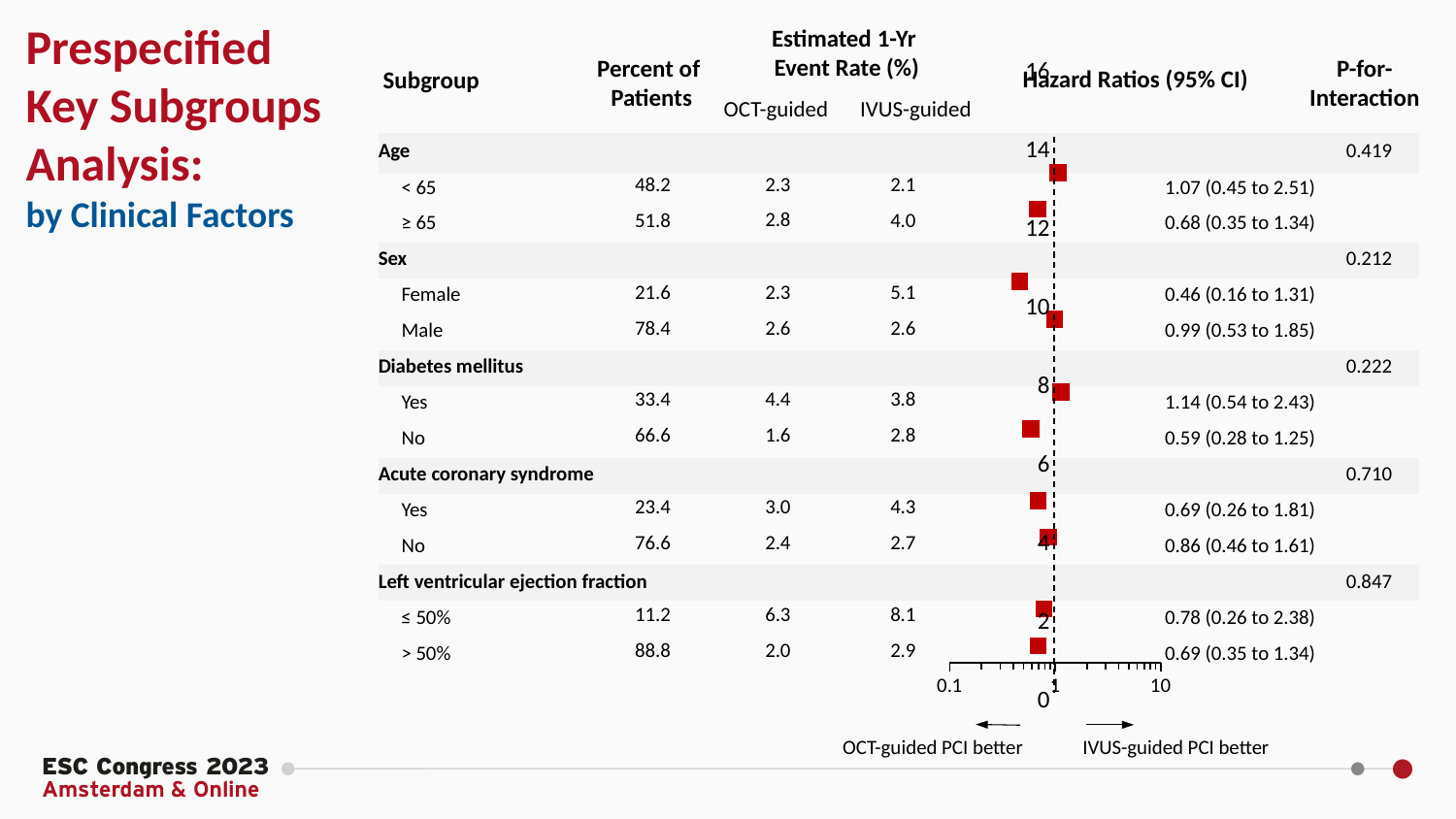
How many subgroup hazard ratio points are plotted in the forest plot? 10 Is the hazard ratio for the Female subgroup greater or less than 1? less What is the hazard ratio (95% CI) for patients with diabetes mellitus (Yes)? 1.14 (0.54 to 2.43) Is the hazard ratio for the Age < 65 subgroup greater or less than 1? greater What kind of chart is used to display the hazard ratios? Forest plot What does the label under the left-pointing arrow below the forest plot say? OCT-guided PCI better Which subgroup has the lowest point estimate hazard ratio in the forest plot? Female What is the hazard ratio (95% CI) for the Age ≥ 65 subgroup? 0.68 (0.35 to 1.34) Which subgroup has the highest point estimate hazard ratio in the forest plot? Diabetes mellitus: Yes What is the hazard ratio (95% CI) for the Female subgroup? 0.46 (0.16 to 1.31) What is the difference between the hazard ratio point estimates for diabetes mellitus Yes and No? 0.55 Which has the larger hazard ratio, the Male subgroup or the Female subgroup? Male